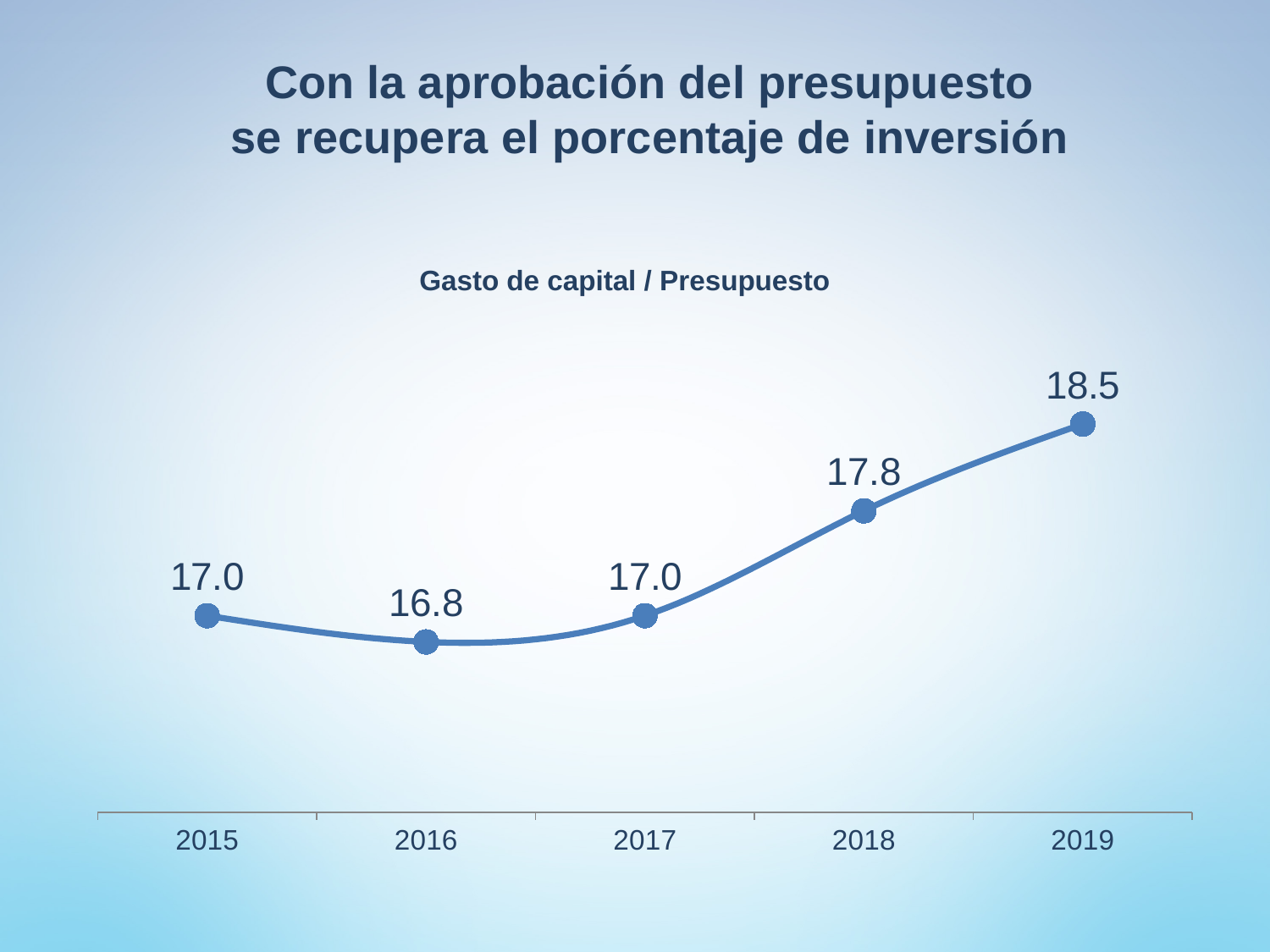
What is the value for 2016? 16.8 How many years are plotted on the chart? 5 Do the values rise or fall from 2017 to 2019? Rise What is the title of the chart? Gasto de capital / Presupuesto Which year has the highest value? 2019 What is the value for 2018? 17.8 What kind of chart is shown on the slide? Line chart What is the difference between the values for 2017 and 2016? 0.2 Which year has the lowest value? 2016 Which is larger, the value for 2018 or the value for 2017? 2018 What is the difference between the values for 2019 and 2018? 0.7 What is the value for 2019? 18.5